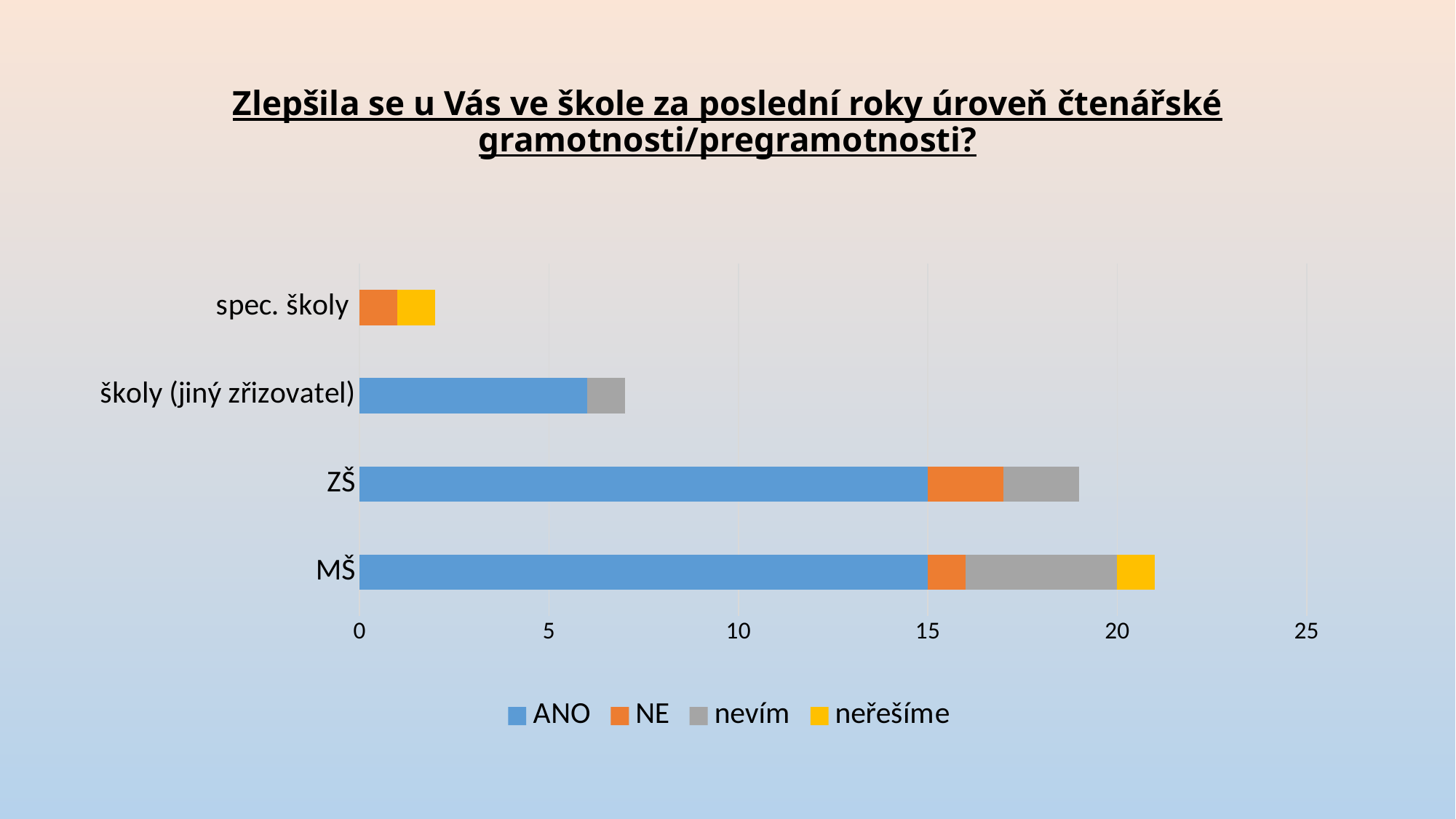
How many series does the legend list? 4 Which series is shown in yellow in the chart? neřešíme Is the total bar for školy (jiný zřizovatel) greater or less than 5? greater Is the total bar for ZŠ greater or less than 20? less What are the four legend entries of the chart? ANO, NE, nevím, neřešíme Is the total bar for MŠ greater or less than 20? greater Which has a longer total bar, ZŠ or školy (jiný zřizovatel)? ZŠ What kind of chart is shown on the slide? bar chart Which category has the longest total bar? MŠ How many categories are shown on the vertical axis of the chart? 4 Which category has the shortest total bar? spec. školy